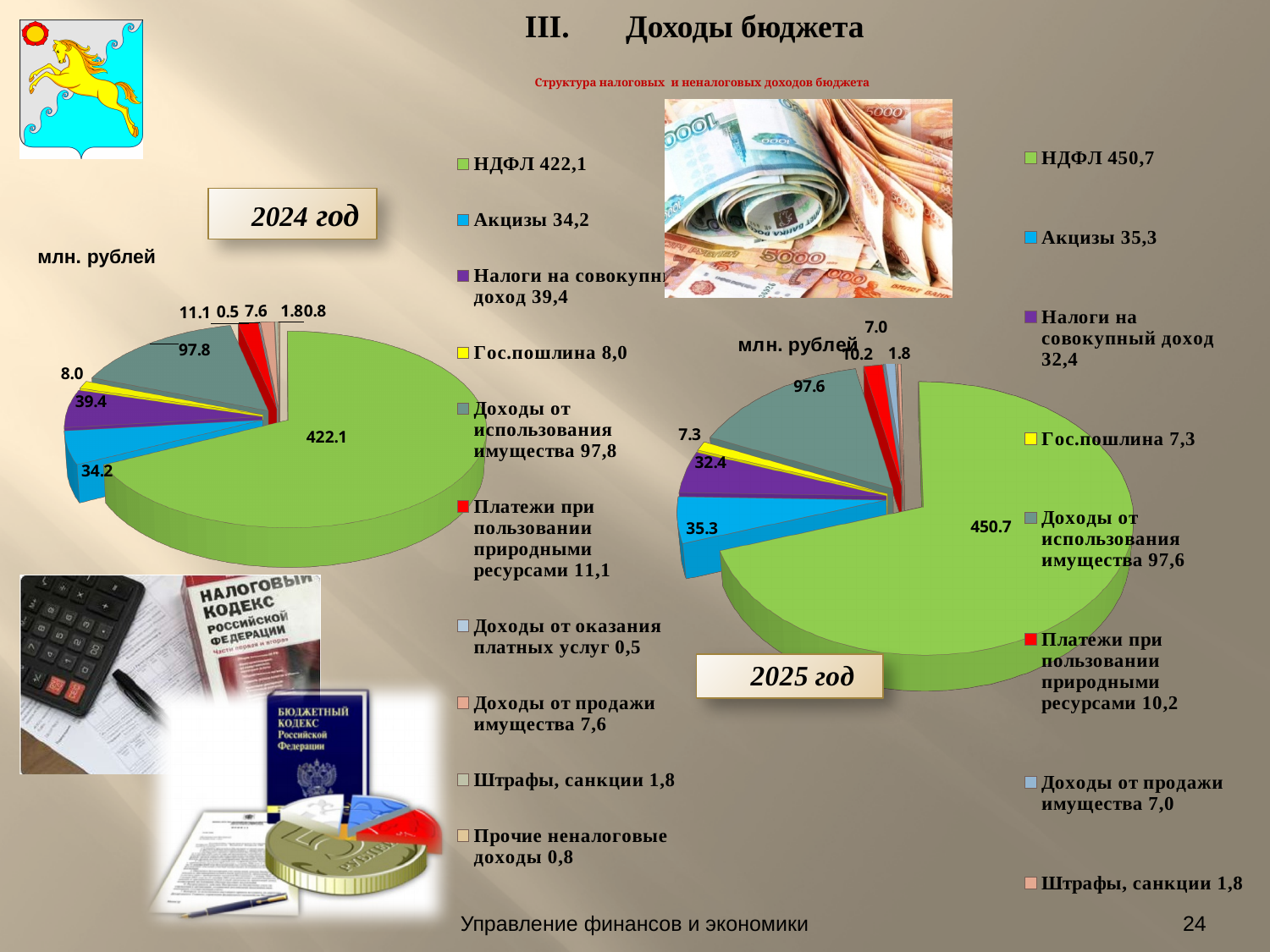
On the 2025 год pie chart, what is the value for Акцизы? 35.3 How many categories does the legend of the 2025 год pie chart list? 8 How many categories does the legend of the 2024 год pie chart list? 10 What unit is shown next to the pie charts on the slide? млн. рублей On the 2024 год pie chart, which is larger: Акцизы or Налоги на совокупный доход? Налоги на совокупный доход What is the difference between the НДФЛ value on the 2025 год chart and the НДФЛ value on the 2024 год chart? 28.6 On the 2025 год pie chart, which category has the largest slice? НДФЛ On the 2024 год pie chart, what is the value for Доходы от использования имущества? 97.8 What type of chart is used to show the 2025 год budget revenue structure? Pie chart On the 2024 год pie chart, what is the value for НДФЛ? 422.1 On the 2024 год pie chart, which category has the smallest value? Доходы от оказания платных услуг On the 2025 год pie chart, what is the value for Налоги на совокупный доход? 32.4